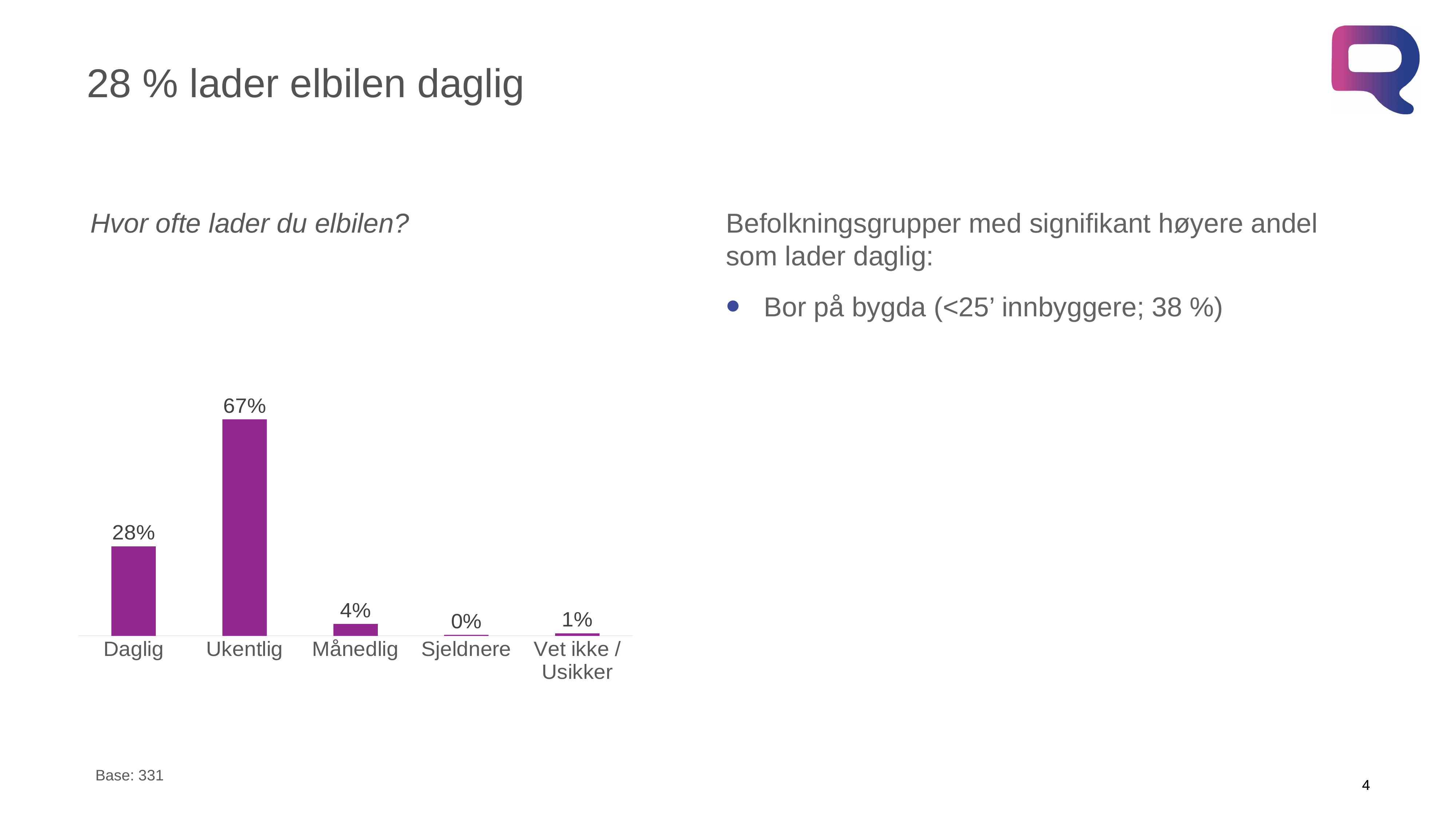
What is the difference between the values for Ukentlig and Daglig? 39% How many categories are shown on the x axis of the chart? 5 Which category has the lowest value? Sjeldnere What kind of chart is shown on the slide? Bar chart What is the value shown for Ukentlig? 67% What percentage of respondents charge their electric car daily (Daglig)? 28% What is the value shown for Vet ikke / Usikker? 1% What question does the chart answer, as written above it? Hvor ofte lader du elbilen? What is the difference between the values for Månedlig and Vet ikke / Usikker? 3% Which is larger, the value for Daglig or the value for Månedlig? Daglig Which category has the highest value? Ukentlig What is the value shown for Månedlig? 4%